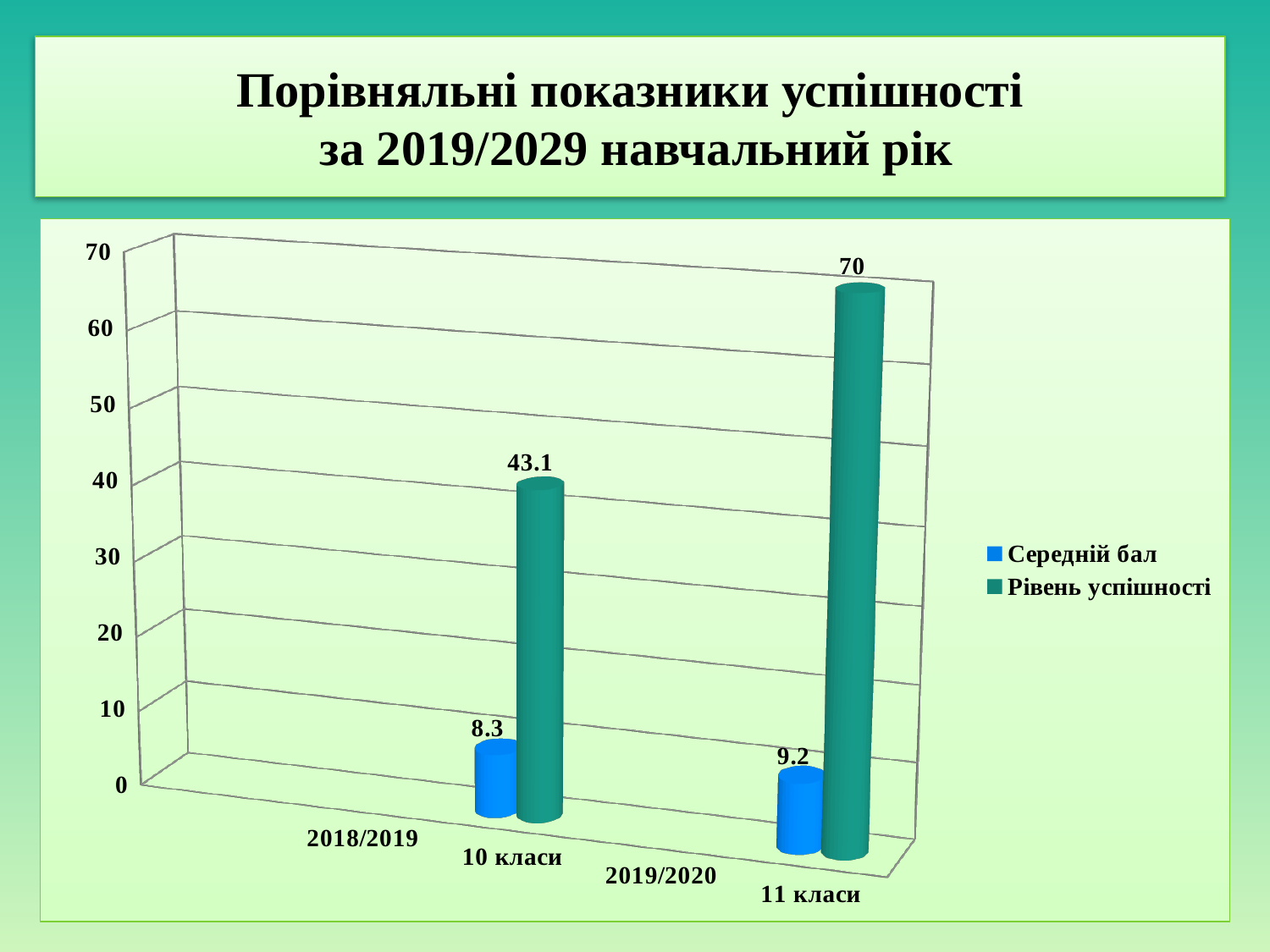
How many series does the legend list? 2 Which category has the higher Рівень успішності? 2019/2020 11 класи Which category has the lower Середній бал? 2018/2019 10 класи What is the difference in Середній бал between 2019/2020 11 класи and 2018/2019 10 класи? 0.9 What is the value of Рівень успішності for 2018/2019 10 класи? 43.1 What is the value of Середній бал for 2019/2020 11 класи? 9.2 What is the value of Рівень успішності for 2019/2020 11 класи? 70 What is the value of Середній бал for 2018/2019 10 класи? 8.3 What is the difference in Рівень успішності between 2019/2020 11 класи and 2018/2019 10 класи? 26.9 Which colour represents Середній бал in the legend? blue Is the Рівень успішності for 2018/2019 10 класи greater or less than 50? less What kind of chart is shown on the slide? bar chart